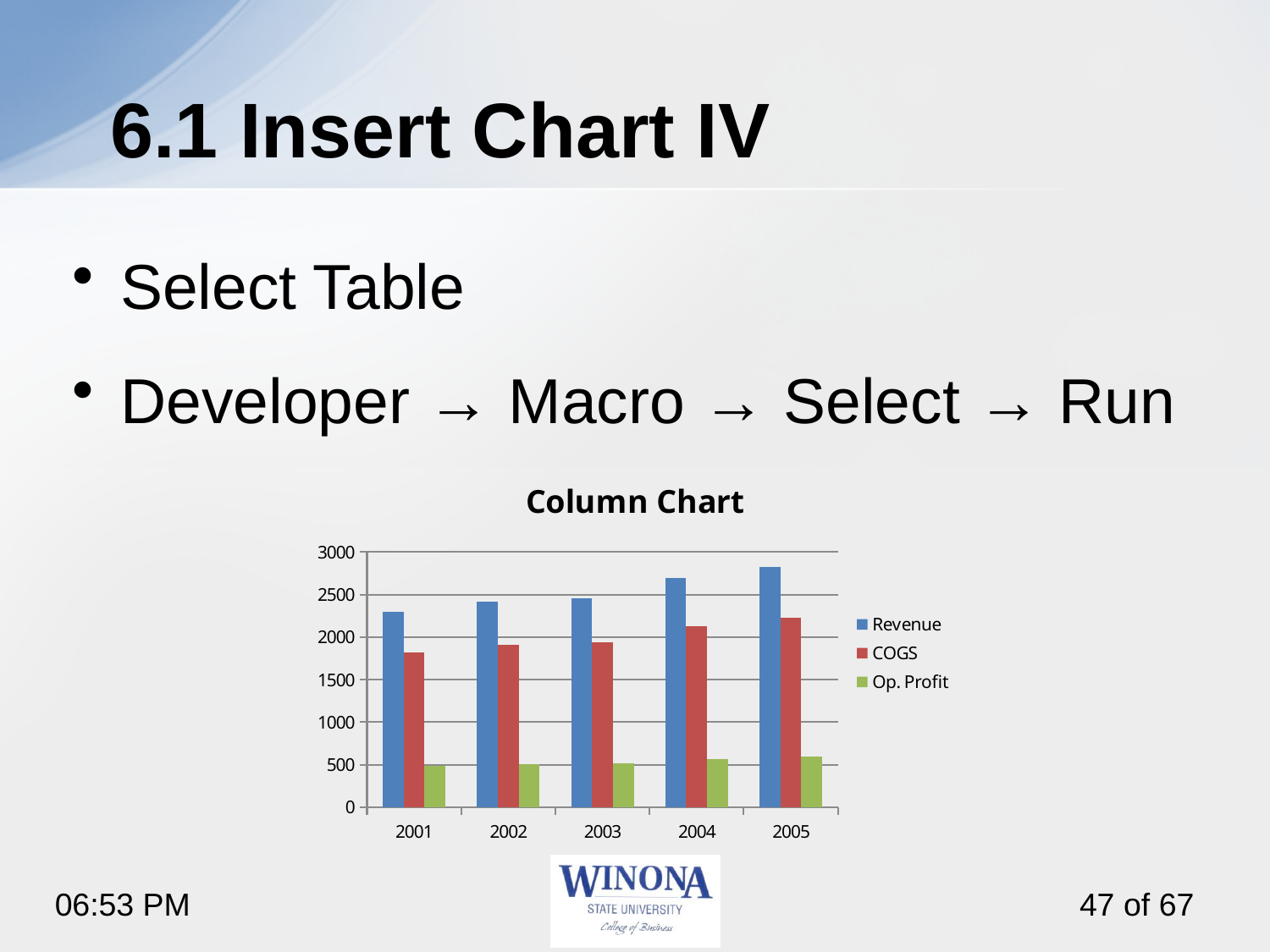
How many series does the legend list? 3 What kind of chart is shown on the slide? bar chart Is the Op. Profit value for 2003 greater or less than 1000? less In 2003, which is larger, Revenue or COGS? Revenue What is the title of the chart? Column Chart How many years are shown on the x axis? 5 Does Revenue rise or fall from 2001 to 2005? rise Is the COGS value for 2001 greater or less than 2000? less In which year is Revenue lowest? 2001 Is the Revenue value for 2001 greater or less than 2500? less In which year is Revenue highest? 2005